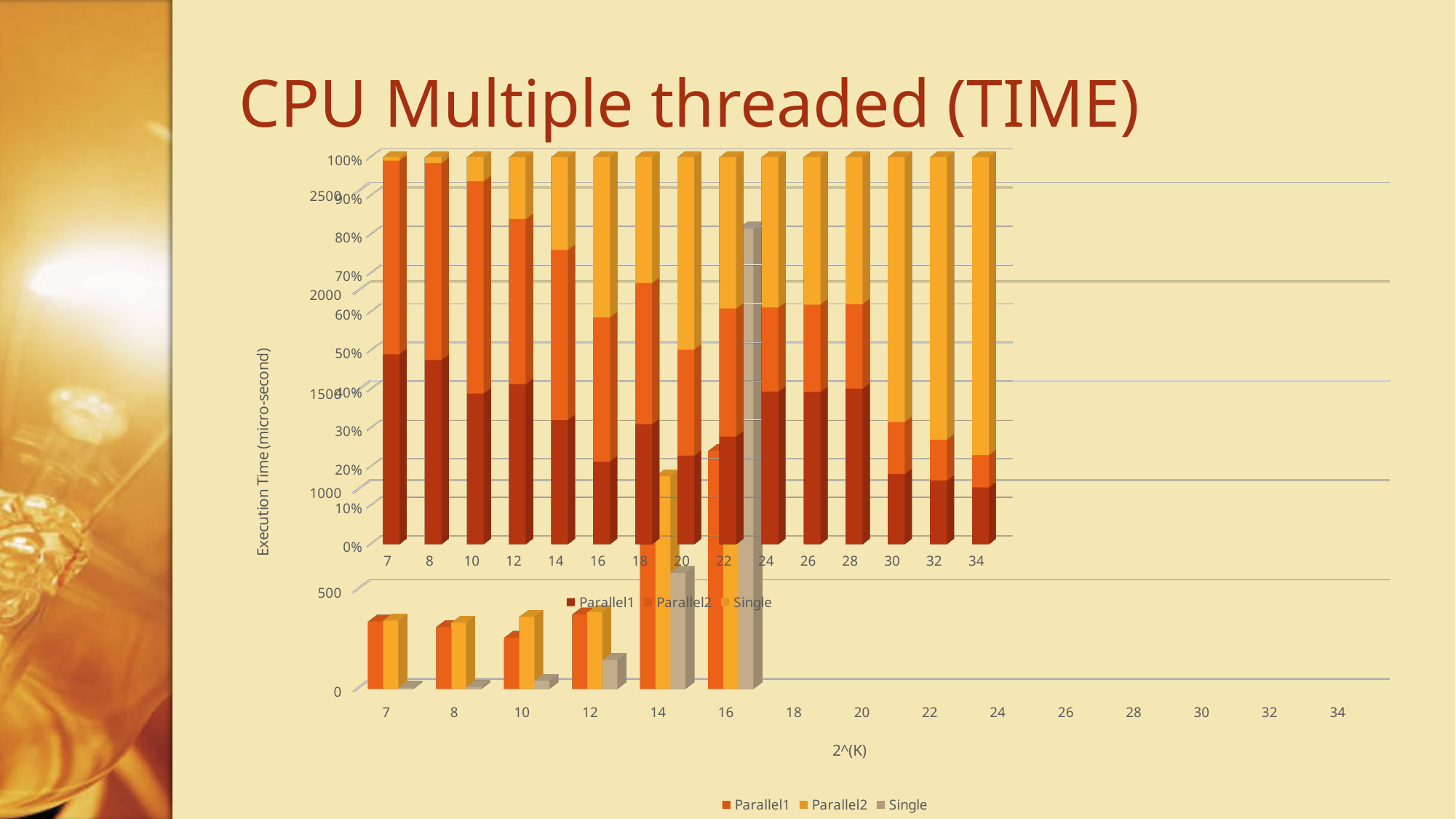
What kind of chart is the upper chart on the slide? stacked bar chart What kind of chart is the lower chart on the slide? bar chart What is the title of the y axis of the lower chart? Execution Time (micro-second) How many series does the legend of the lower chart list? 3 How many categories are shown on the x axis of the lower chart? 15 In the lower chart, is the Single value at 14 greater or less than 500? greater In the lower chart, is the Parallel1 value at 7 greater or less than 500? less What is the title of the x axis of the lower chart? 2^(K) In the lower chart, which is larger at 7: Parallel1 or Single? Parallel1 In the lower chart, is the Single value at 16 greater or less than 2000? greater In the lower chart, which is larger at 16: Single or Parallel1? Single